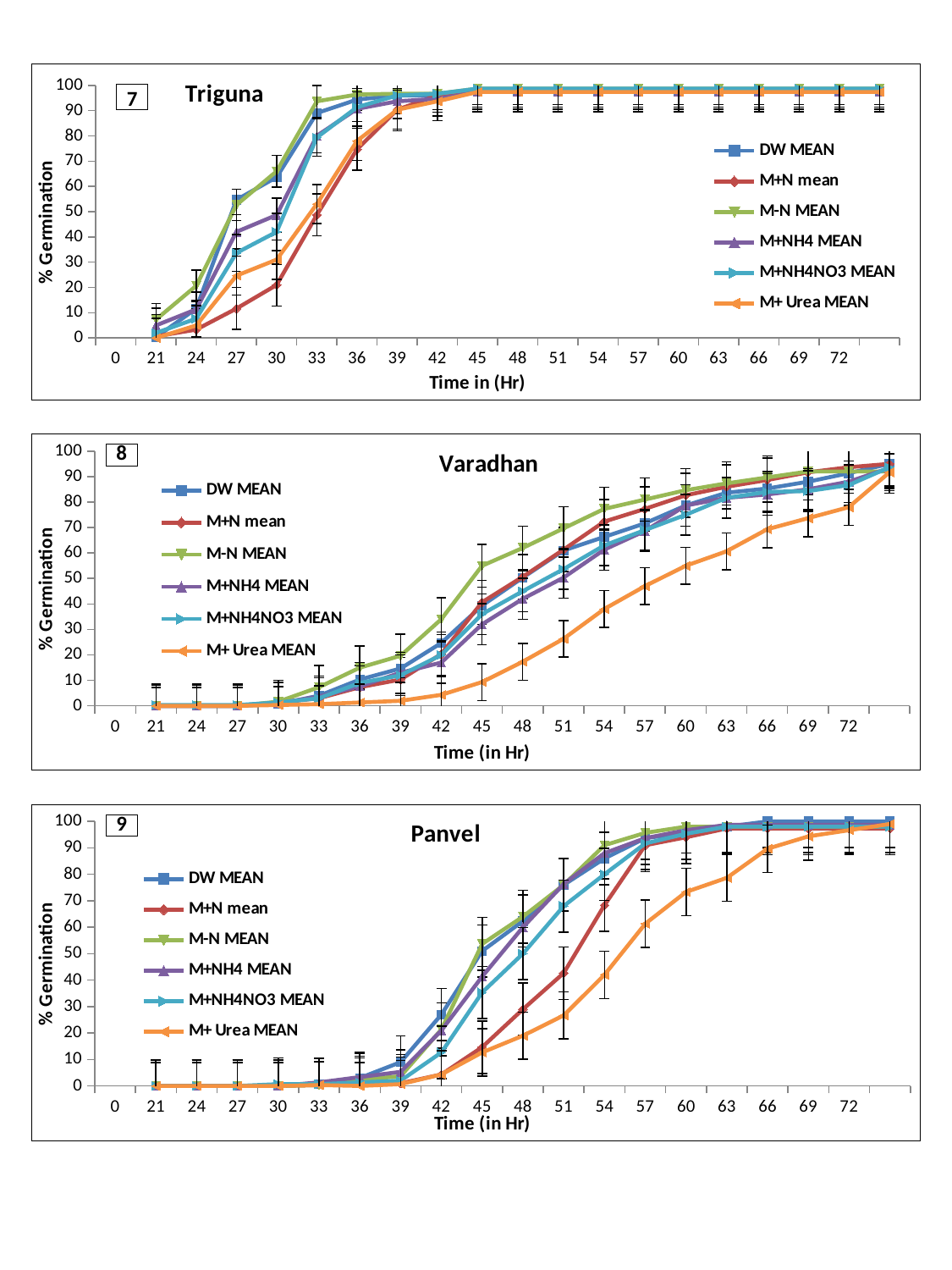
In the Varadhan chart, which series has the highest value at 54 hours? M-N MEAN How many series does the legend of the Varadhan chart list? 6 In the Panvel chart, does the DW MEAN series rise or fall as time increases along the x axis? rise In the Triguna chart, is the value for M+N mean at 27 hours greater or less than 20? less In the Varadhan chart, at 45 hours, which is larger: M-N MEAN or M+ Urea MEAN? M-N MEAN In the Panvel chart, which series has the lowest value at 57 hours? M+ Urea MEAN In the Panvel chart, is the value for M+N mean at 54 hours greater or less than 60? greater What kind of chart is the Triguna chart? line chart How many charts are shown on the slide? 3 What is the x-axis title of the Triguna chart? Time in (Hr) What number is shown in the box at the top left of the Panvel chart? 9 In the Varadhan chart, is the value for M+ Urea MEAN at 66 hours greater or less than 60? greater